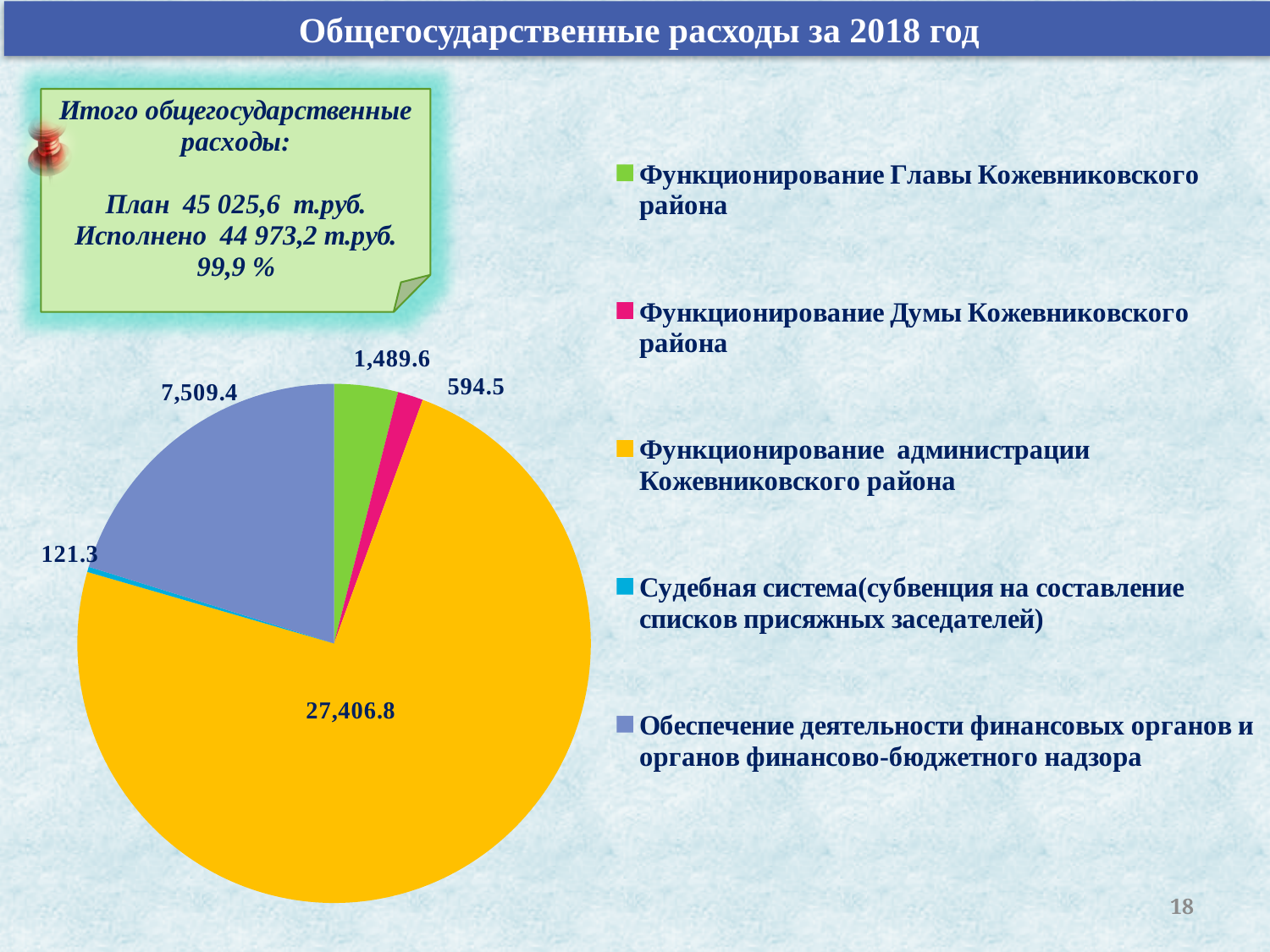
What colour is the slice for Функционирование администрации Кожевниковского района? Yellow What is the value for Функционирование Думы Кожевниковского района? 594.5 What is the value for Функционирование администрации Кожевниковского района? 27,406.8 Which category has the largest slice of the pie? Функционирование администрации Кожевниковского района Which is larger: the value for Функционирование Главы Кожевниковского района or the value for Функционирование Думы Кожевниковского района? Функционирование Главы Кожевниковского района What is the value for Обеспечение деятельности финансовых органов и органов финансово-бюджетного надзора? 7,509.4 What is the difference between the value for Функционирование администрации Кожевниковского района and the value for Обеспечение деятельности финансовых органов и органов финансово-бюджетного надзора? 19,897.4 What is the value for Судебная система (субвенция на составление списков присяжных заседателей)? 121.3 Which category has the smallest slice of the pie? Судебная система (субвенция на составление списков присяжных заседателей) What type of chart is shown on the slide? Pie chart How many categories does the pie chart show? 5 What is the value for Функционирование Главы Кожевниковского района? 1,489.6